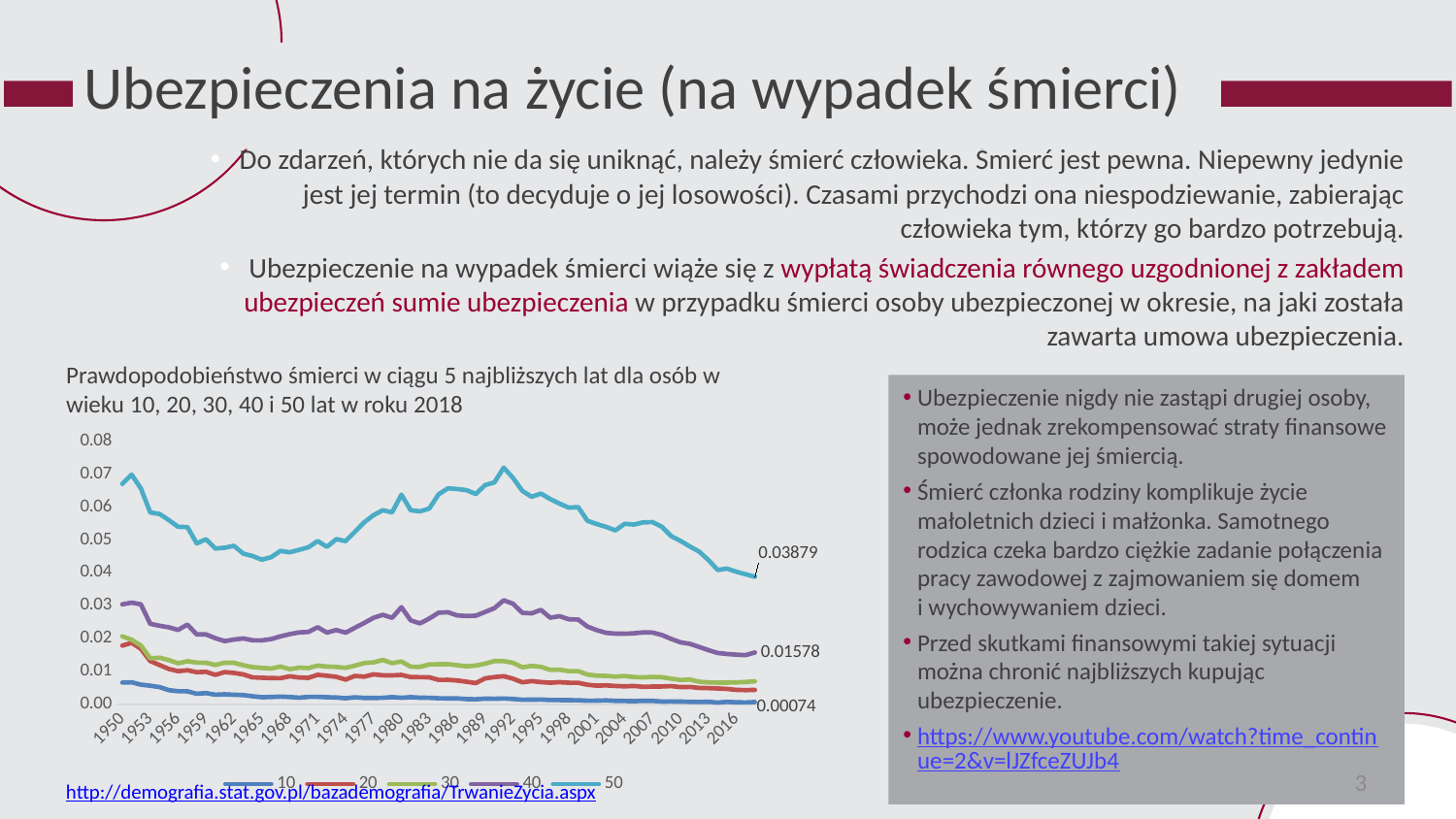
What is the final labelled value for the series '50'? 0.03879 What is the final labelled value for the series '10'? 0.00074 What is the difference between the final labelled values of the series '50' and '40'? 0.02301 What kind of chart is shown on the slide? line chart How many series does the chart legend list? 5 Does the series '50' rise or fall between 1992 and 2016? fall Which series has the lowest values across the chart? 10 What are the legend entries of the chart? 10, 20, 30, 40, 50 Which series has the highest values across the chart? 50 Which series has the higher final labelled value, '40' or '10'? 40 What is the final labelled value for the series '40'? 0.01578 Is the value for the series '50' around 1992 greater or less than 0.06? greater